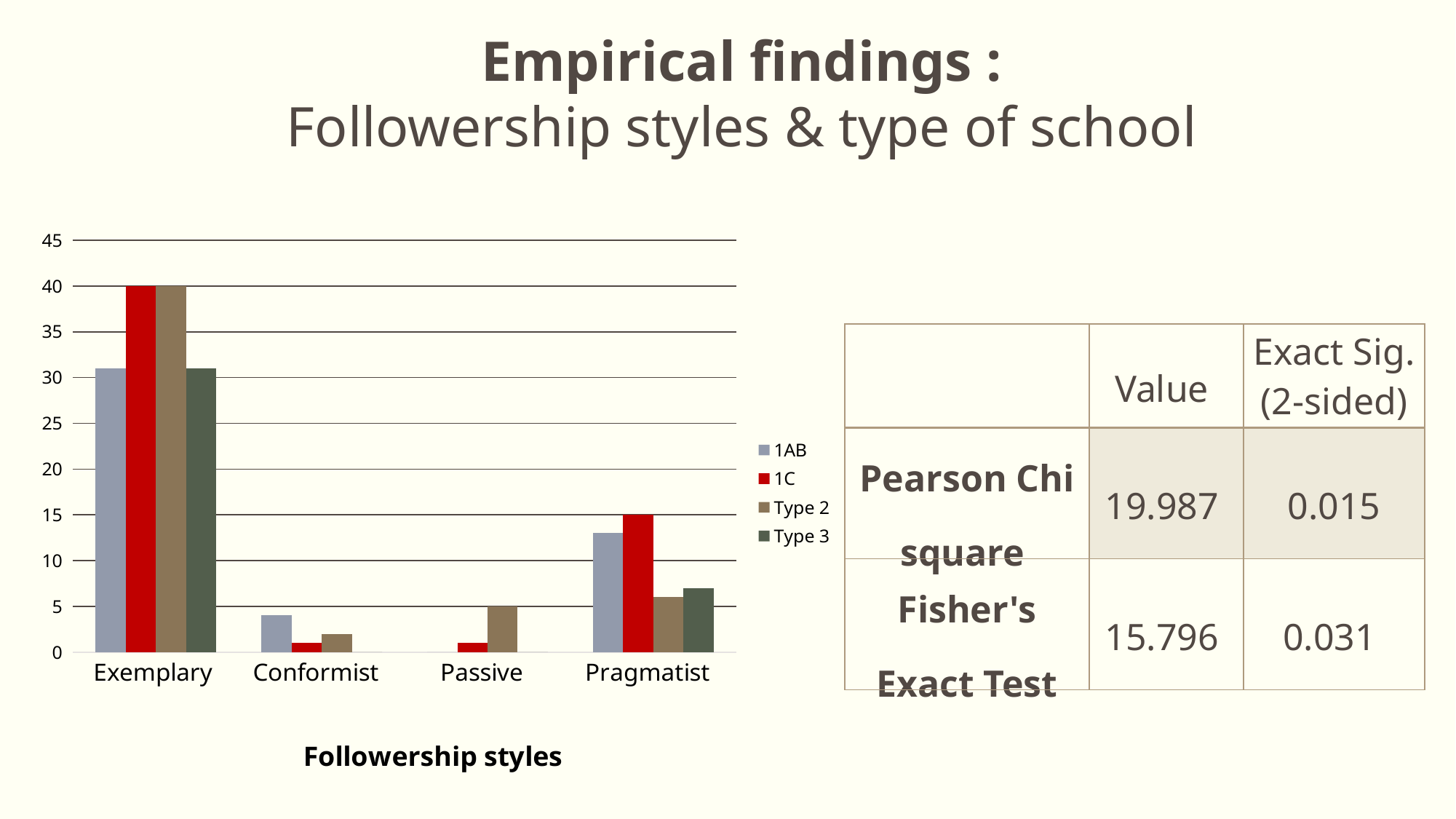
Which followership style has the highest value for the 1C series? Exemplary What is the value for Type 2 in the Passive category? 5 What is the value for 1C in the Pragmatist category? 15 What is the value for 1C in the Exemplary category? 40 How many followership style categories are shown on the x axis? 4 Is the value for 1AB in the Pragmatist category greater or less than 10? greater What is the title of the chart's x axis? Followership styles What kind of chart is shown on the slide? bar chart In the Pragmatist category, which is larger: the 1C value or the Type 2 value? 1C How many series does the chart legend list? 4 Which followership style has the lowest value for the Type 2 series? Conformist Is the value for 1AB in the Exemplary category greater or less than 35? less